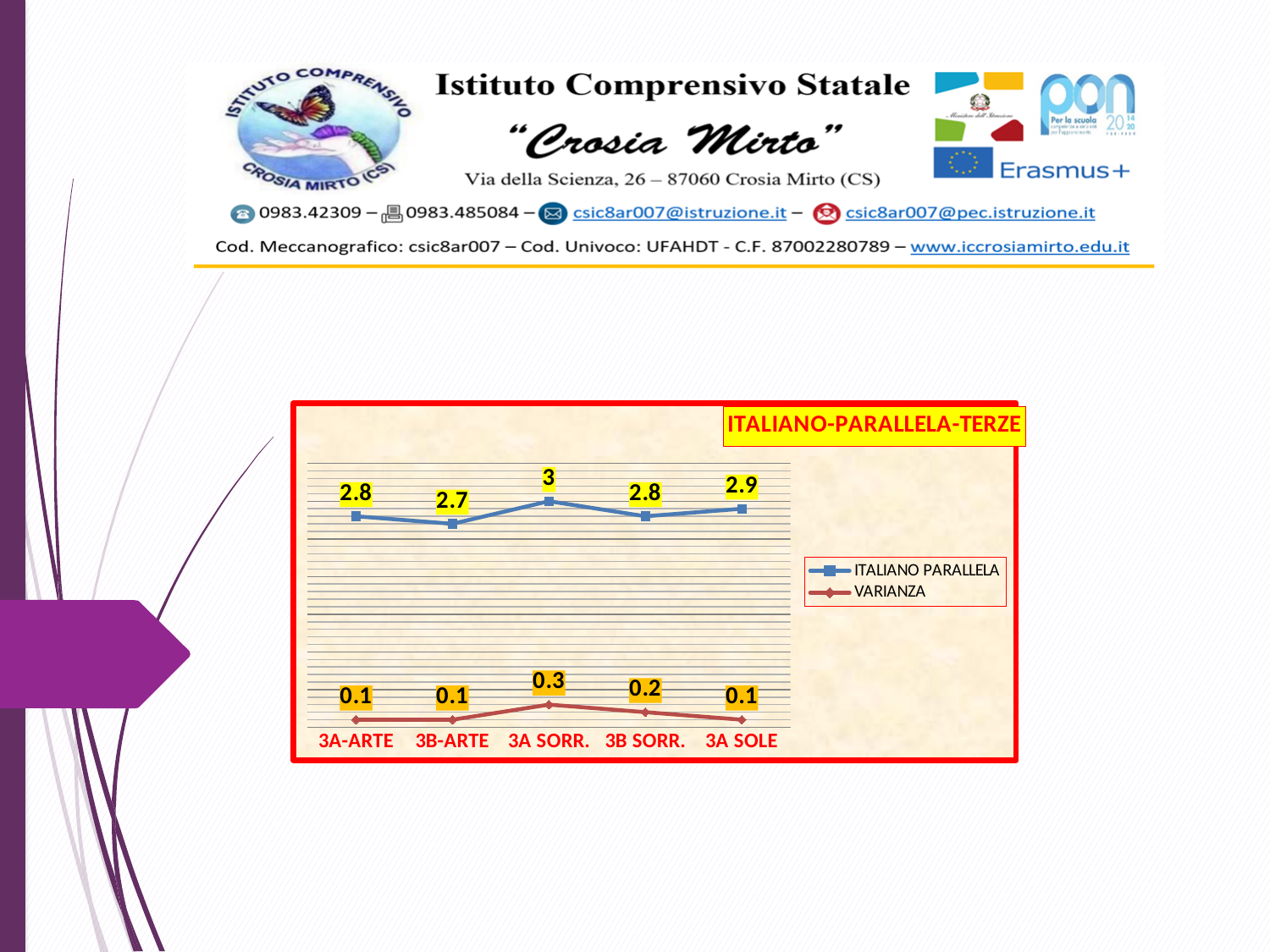
How many categories are shown on the x axis? 5 Which category has the lowest ITALIANO PARALLELA value? 3B-ARTE Which is larger, the ITALIANO PARALLELA value for 3A SOLE or for 3B SORR.? 3A SOLE What is the ITALIANO PARALLELA value for 3A SORR.? 3 What kind of chart is shown? line chart Which category has the highest VARIANZA value? 3A SORR. How many series does the legend list? 2 Which category has the highest ITALIANO PARALLELA value? 3A SORR. What is the title of the chart? ITALIANO-PARALLELA-TERZE What is the ITALIANO PARALLELA value for 3B-ARTE? 2.7 What is the difference between the ITALIANO PARALLELA values for 3A SORR. and 3B-ARTE? 0.3 What is the VARIANZA value for 3B SORR.? 0.2